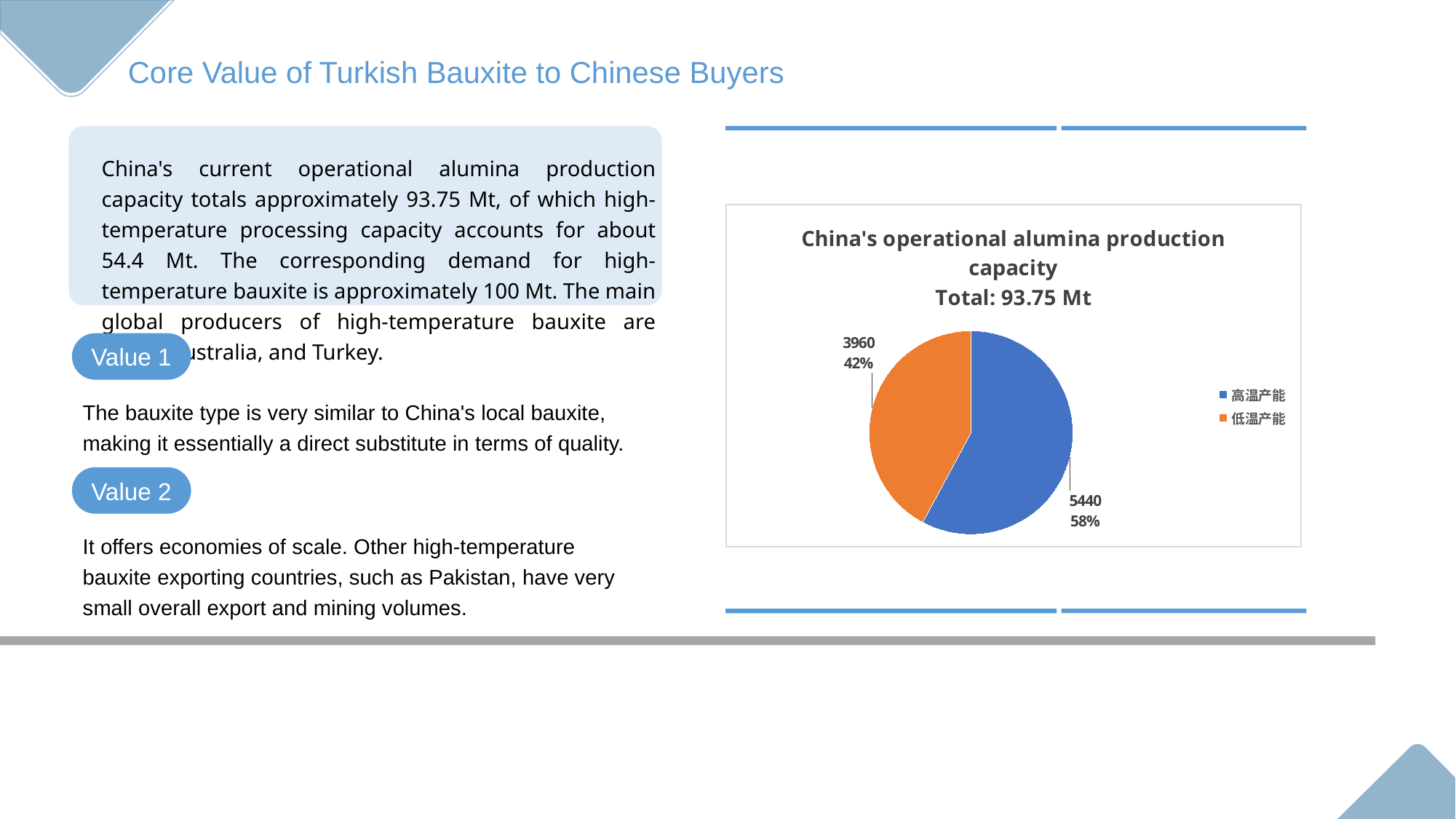
How many slices does the pie chart have? 2 What total is stated in the chart title? 93.75 Mt What is the difference between the values for 高温产能 and 低温产能? 1480 Which is larger, the value for 高温产能 or the value for 低温产能? 高温产能 What type of chart is shown on the slide? pie chart What share of the pie does 低温产能 represent? 42% How many entries does the chart legend list? 2 Which category has the smallest slice in the pie chart? 低温产能 What share of the pie does 高温产能 represent? 58% Which category has the largest slice in the pie chart? 高温产能 What is the value for 高温产能 in the pie chart? 5440 What is the value for 低温产能 in the pie chart? 3960